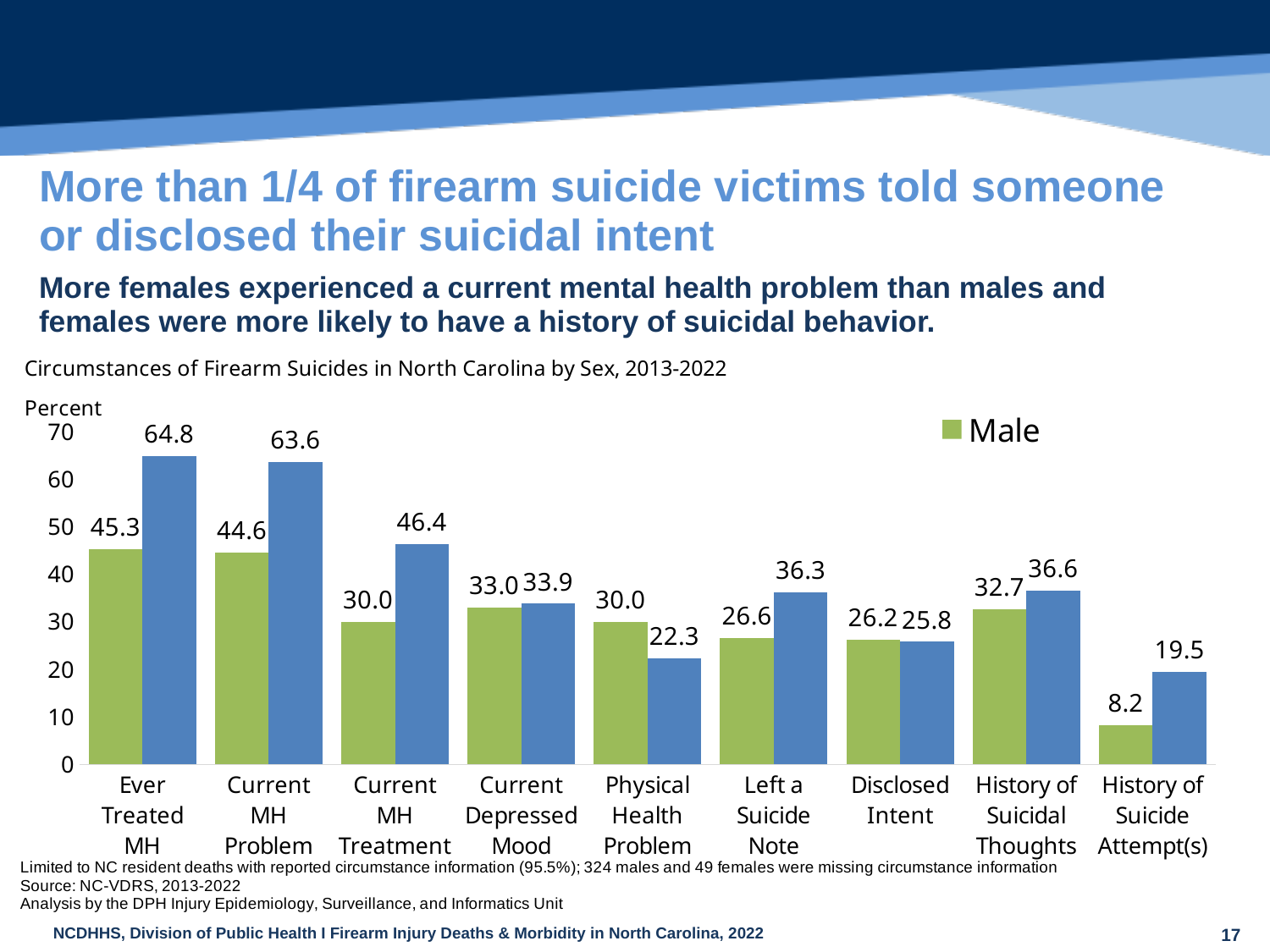
For Physical Health Problem, which is larger: the Male bar or the blue bar? Male bar Which category has the lowest Male value? History of Suicide Attempt(s) What is the Male value for Ever Treated MH? 45.3 How many circumstance categories are shown on the x axis? 9 Which category has the highest Male value? Ever Treated MH What is the difference between the blue bar and the Male bar for Ever Treated MH? 19.5 What is the title of the chart? Circumstances of Firearm Suicides in North Carolina by Sex, 2013-2022 What type of chart is shown on the slide? Bar chart For Left a Suicide Note, which is larger: the Male bar or the blue bar? Blue bar What is the Male value for History of Suicide Attempt(s)? 8.2 What is the value of the blue bar for Physical Health Problem? 22.3 What is the value of the blue bar for Current MH Problem? 63.6